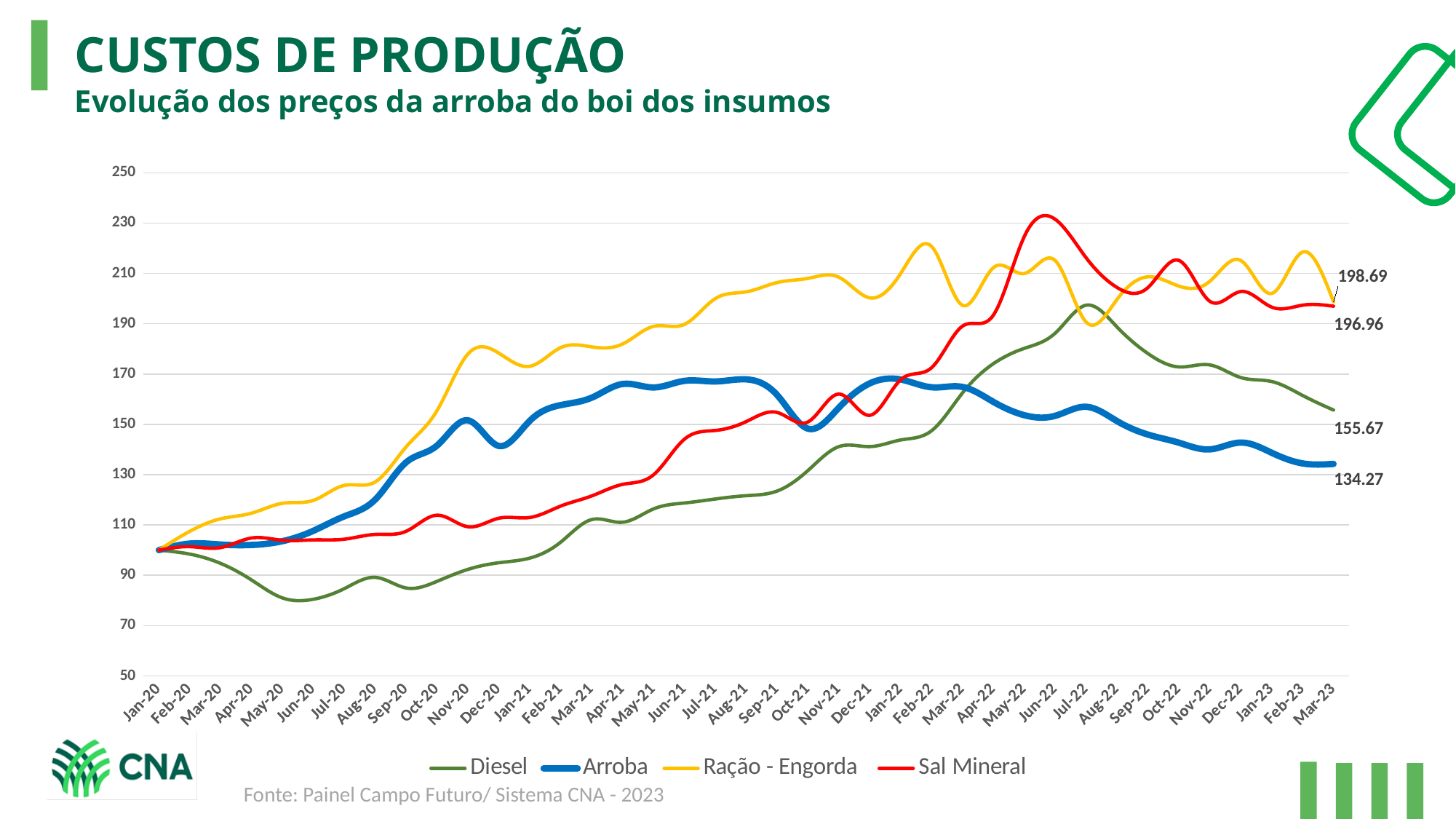
What is the value of Sal Mineral in Mar-23? 196.96 Which series has the highest value in Mar-23? Ração - Engorda What kind of chart is shown on the slide? line chart Does the Diesel line rise or fall between Jul-22 and Mar-23? fall What is the value of Diesel in Mar-23? 155.67 How many series does the legend list? 4 What is the difference between the Diesel and Arroba values in Mar-23? 21.40 Which series has the lowest value in Mar-23? Arroba What is the value of Arroba in Mar-23? 134.27 Which series is drawn in yellow? Ração - Engorda Is the value for Sal Mineral in Jun-22 greater or less than 210? greater What is the value of Ração - Engorda in Mar-23? 198.69